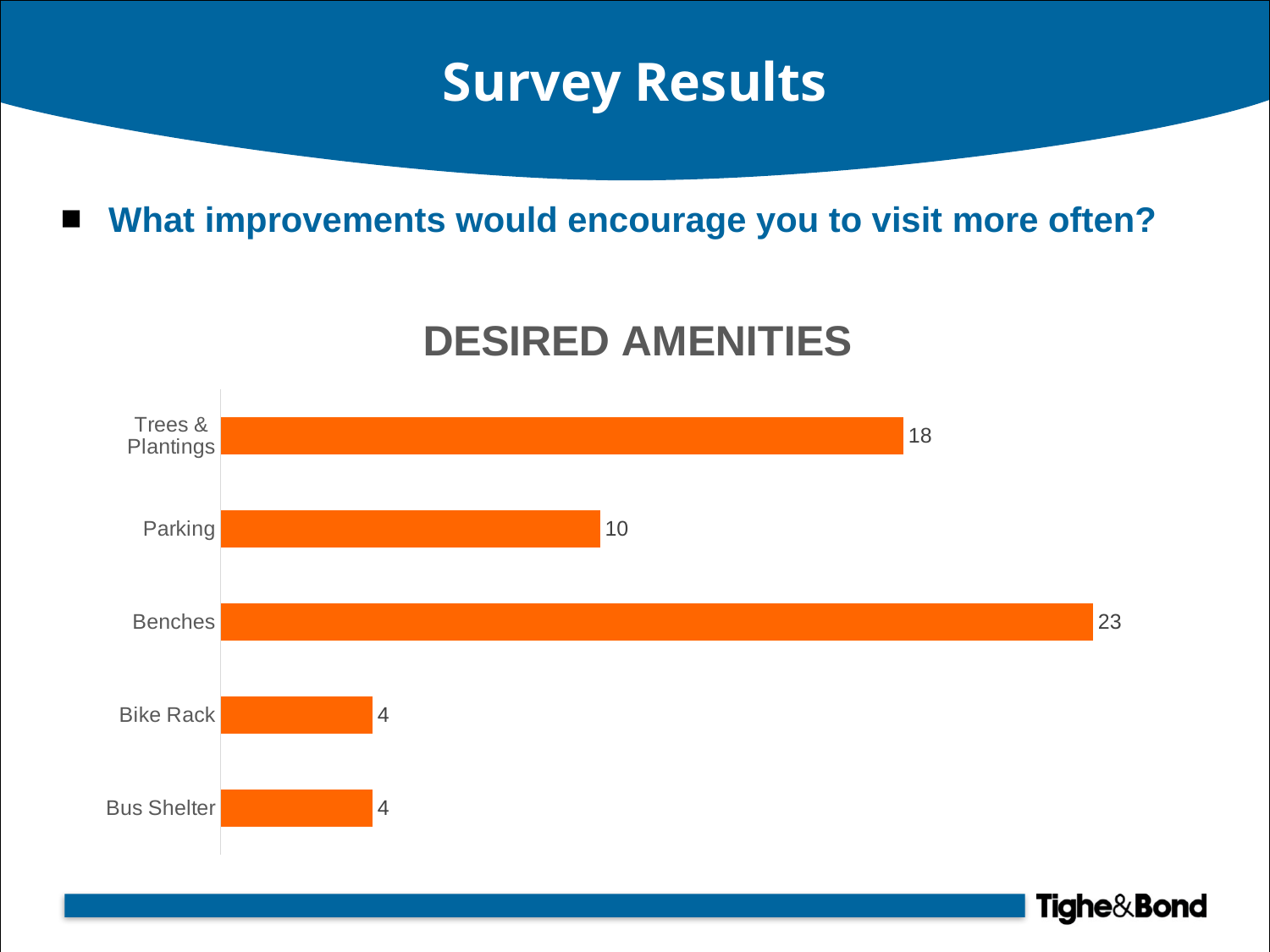
What colour are the bars in the chart? Orange What is the difference between the values for Trees & Plantings and Parking? 8 What is the value for Bike Rack? 4 Which is larger, the value for Parking or the value for Bus Shelter? Parking What is the title of the chart? DESIRED AMENITIES How many categories are shown in the chart? 5 Which category has the highest value? Benches What is the value for Trees & Plantings? 18 What is the value for Parking? 10 What is the difference between the values for Benches and Trees & Plantings? 5 What kind of chart is shown on the slide? Bar chart What is the value for Benches? 23